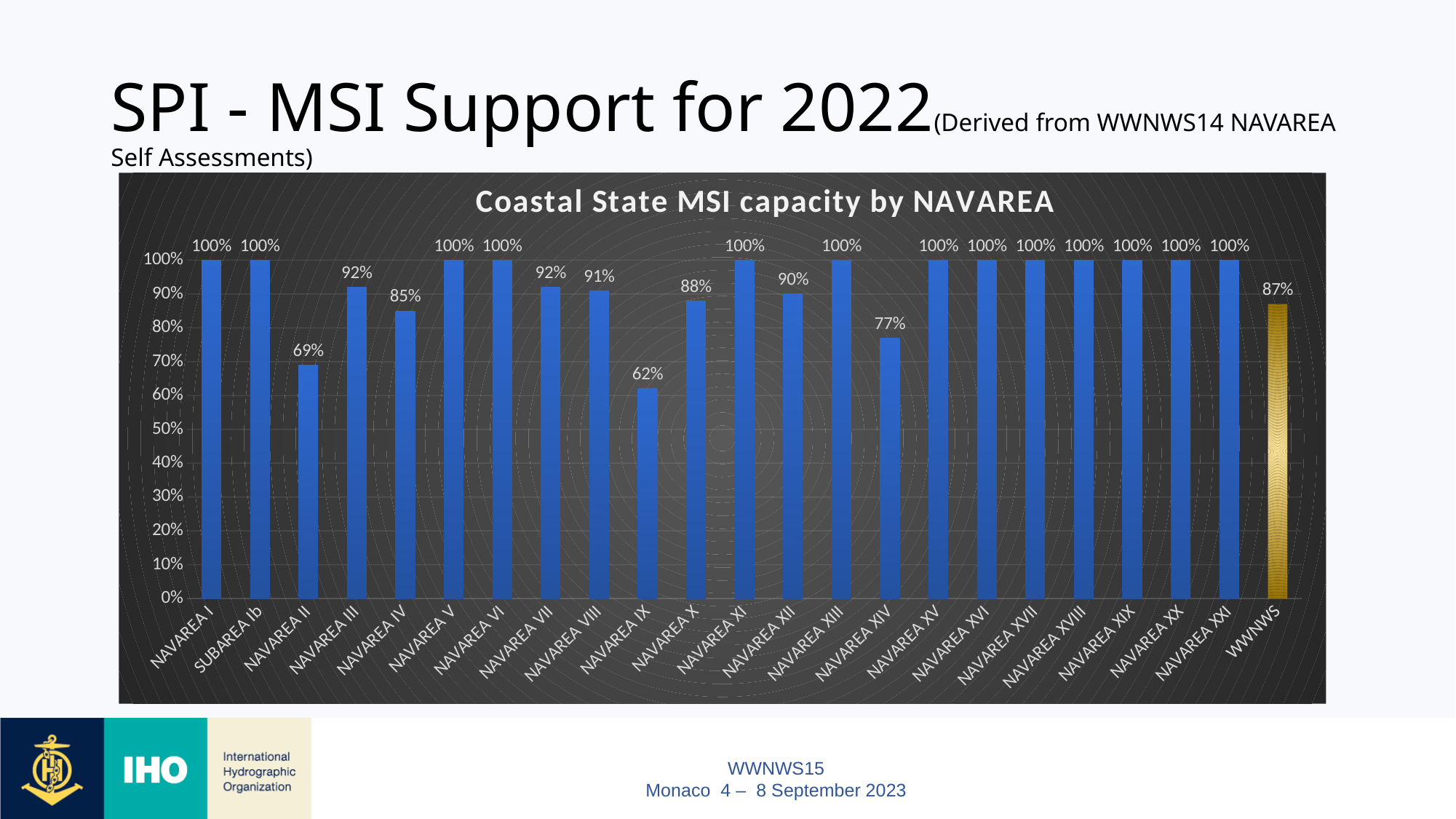
What is the value for NAVAREA XIV? 77% What is the value for NAVAREA II? 69% Which is larger, the value for NAVAREA XIV or the value for WWNWS? WWNWS How many bars are plotted in the chart? 23 What kind of chart is shown on the slide? Bar chart What is the value for WWNWS? 87% What is the title of the chart? Coastal State MSI capacity by NAVAREA Which category has the lowest value? NAVAREA IX What is the difference between the values for NAVAREA I and NAVAREA IX? 38% What is the value for NAVAREA IX? 62% What is the difference between the values for NAVAREA III and NAVAREA IV? 7% Which is larger, the value for NAVAREA X or the value for NAVAREA XII? NAVAREA XII